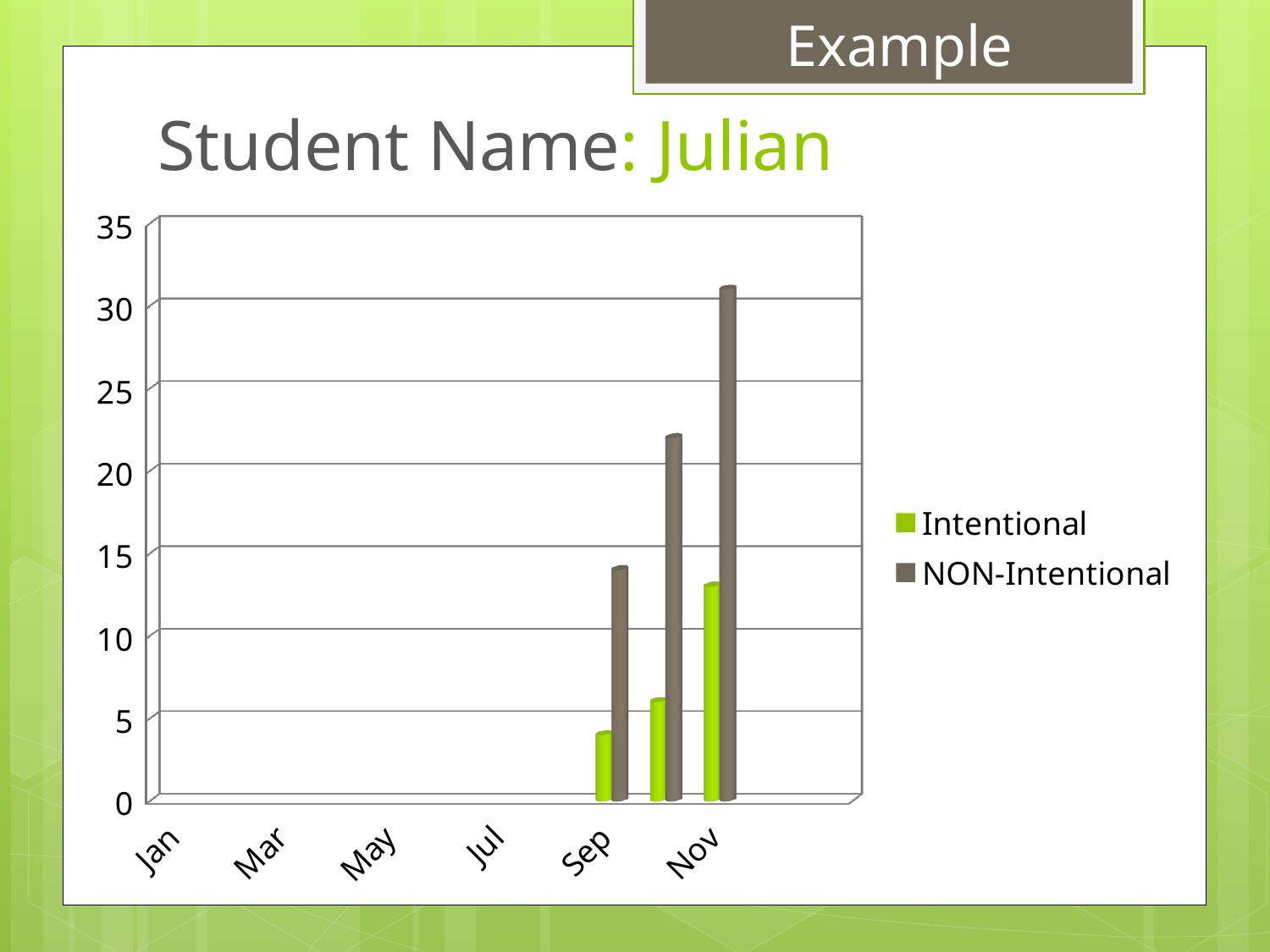
How many month labels are shown on the x axis? 6 Is the Intentional value for Sep greater or less than 10? less Do the NON-Intentional values rise or fall from Sep to Nov? rise Which series is shown in green? Intentional Is the Intentional value for Nov greater or less than 10? greater What kind of chart is shown on the slide? bar chart Is the NON-Intentional value for Sep greater or less than 10? greater Which month has the highest NON-Intentional value? Nov For Nov, which is larger, the Intentional or the NON-Intentional value? NON-Intentional How many series does the legend list? 2 What are the two series named in the legend? Intentional and NON-Intentional